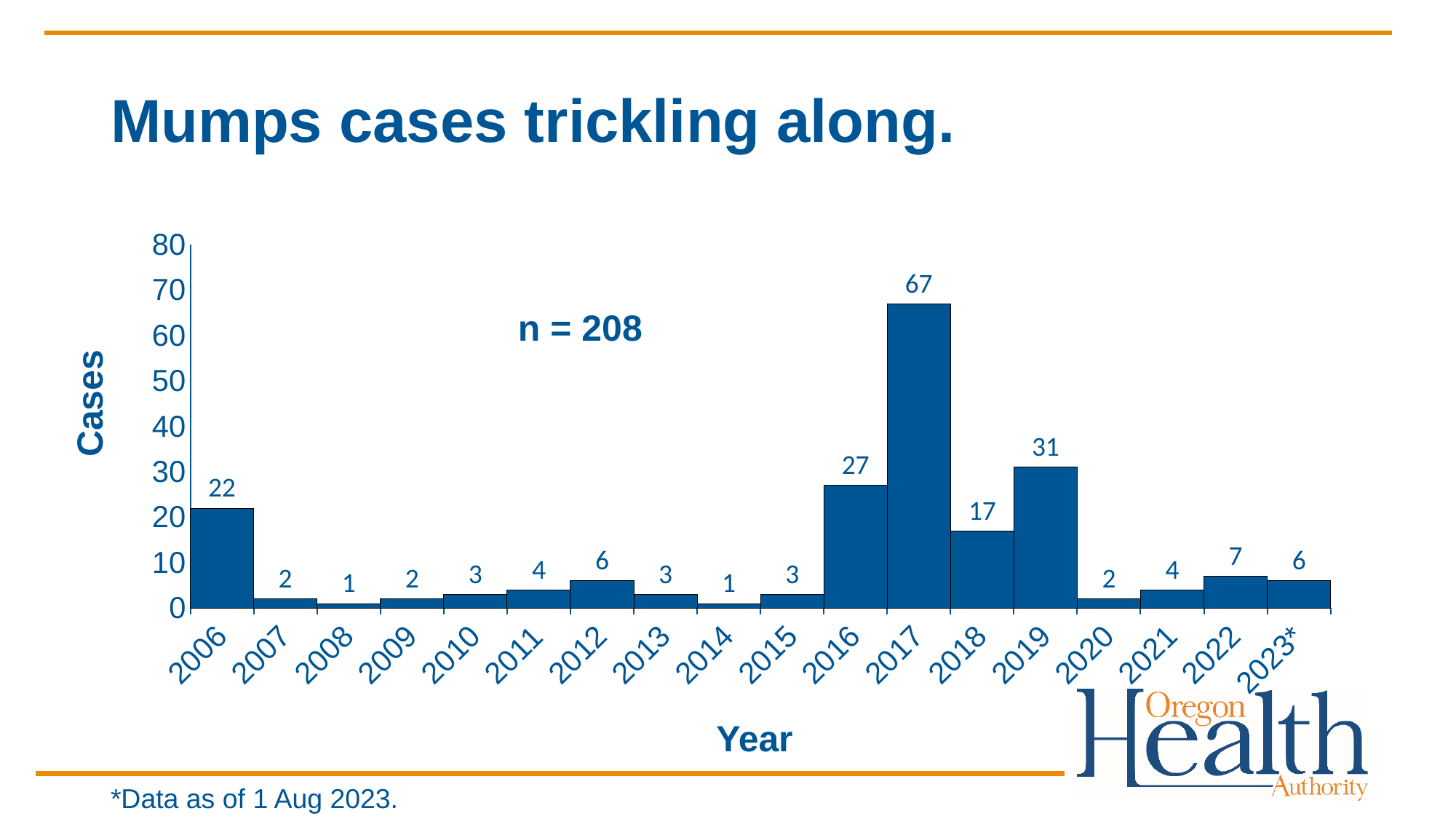
What kind of chart is shown on the slide? bar chart What is the label of the y axis of the chart? Cases Which year had more cases, 2012 or 2022? 2022 Which year had the highest number of mumps cases? 2017 How many mumps cases were reported in 2017? 67 What is the difference in cases between 2019 and 2016? 4 How many years are shown on the x axis of the chart? 18 How many mumps cases were reported in 2019? 31 What total number of cases (n) is printed on the chart? n = 208 Which year had more cases, 2016 or 2019? 2019 How many mumps cases were reported in 2006? 22 What is the difference in cases between 2017 and 2018? 50